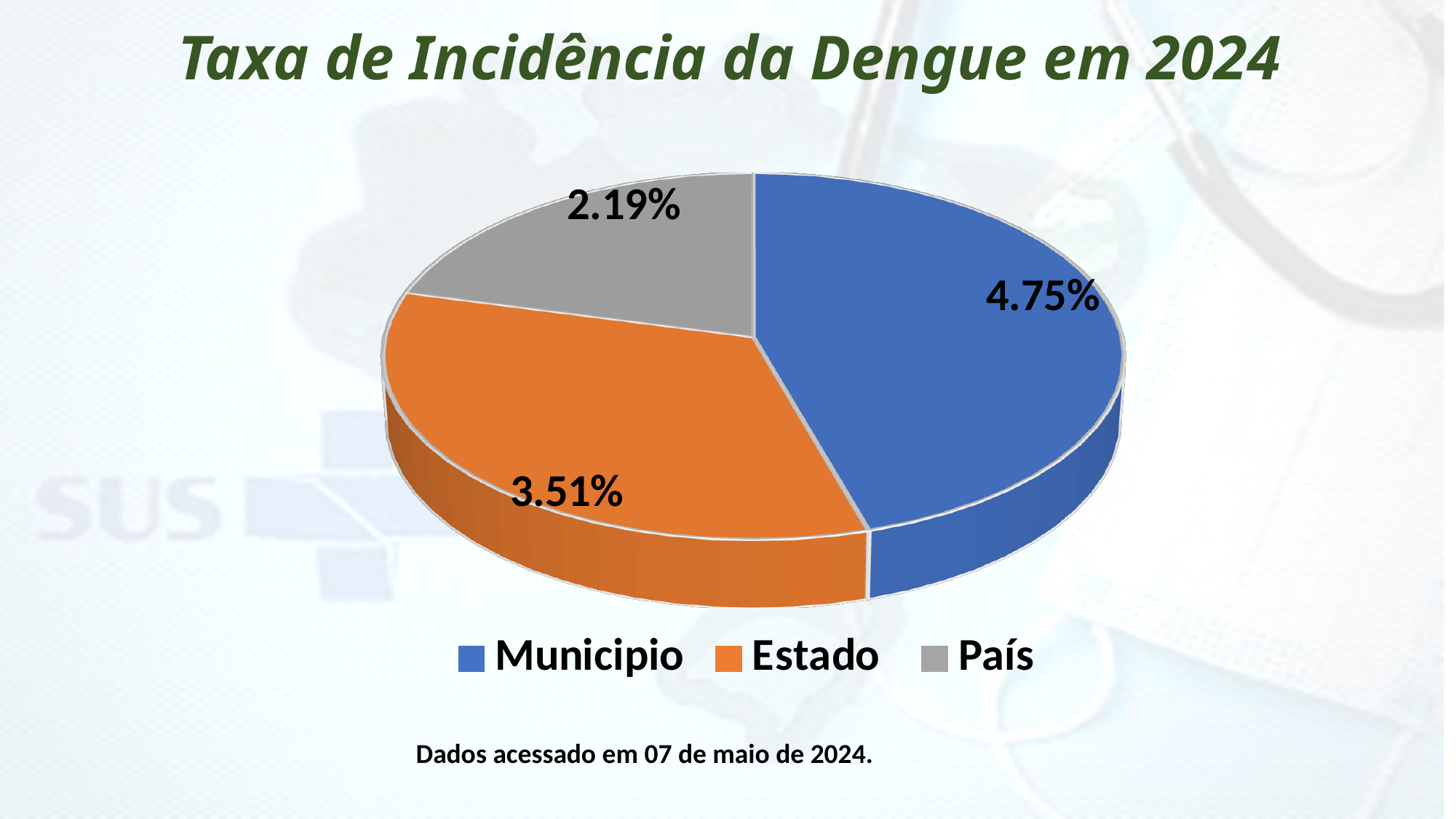
What is the title of the chart? Taxa de Incidência da Dengue em 2024 How many slices does the pie chart have? 3 What type of chart is shown on the slide? pie chart What is the difference between the values for Municipio and Estado? 1.24% Which category has the highest value? Municipio What value is shown for Municipio? 4.75% What is the difference between the values for Estado and País? 1.32% What value is shown for Estado? 3.51% Which is larger, the value for Estado or the value for País? Estado Which category has the lowest value? País What value is shown for País? 2.19% Which colour represents Estado in the legend? orange